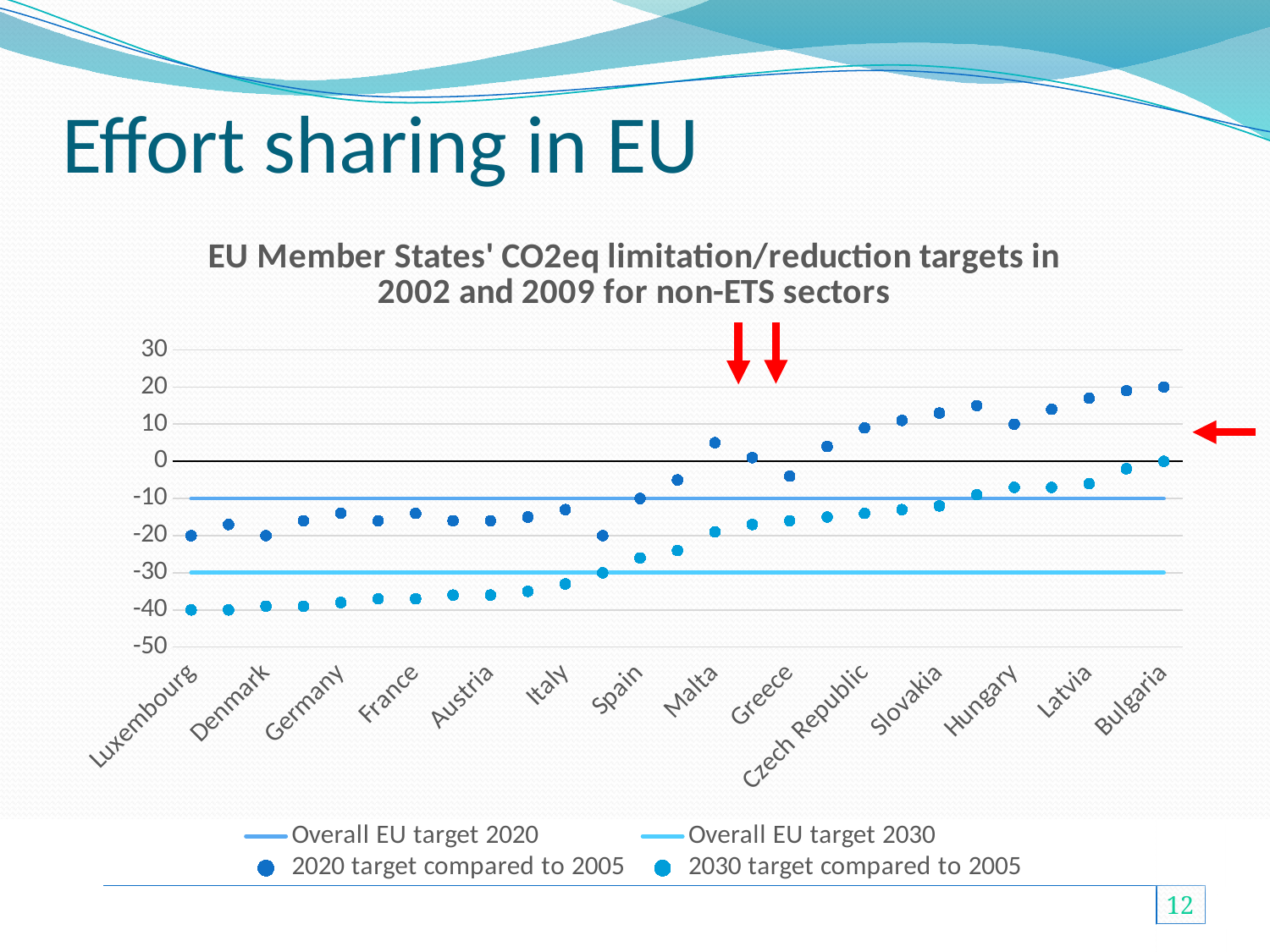
Do the 2020 target compared to 2005 values generally rise or fall from left to right along the x axis? Rise What is Luxembourg's 2020 target compared to 2005? -20 What kind of chart is shown on the slide? Scatter (dot) chart What is the title of the chart? EU Member States' CO2eq limitation/reduction targets in 2002 and 2009 for non-ETS sectors Which is larger, the 2020 target compared to 2005 for Luxembourg or for Bulgaria? Bulgaria How many series does the legend list? 4 At what value is the Overall EU target 2020 line drawn? -10 What is Luxembourg's 2030 target compared to 2005? -40 What is Bulgaria's 2020 target compared to 2005? 20 What is the difference between the Overall EU target 2020 line and the Overall EU target 2030 line? 20 At what value is the Overall EU target 2030 line drawn? -30 Which country has the highest 2020 target compared to 2005? Bulgaria